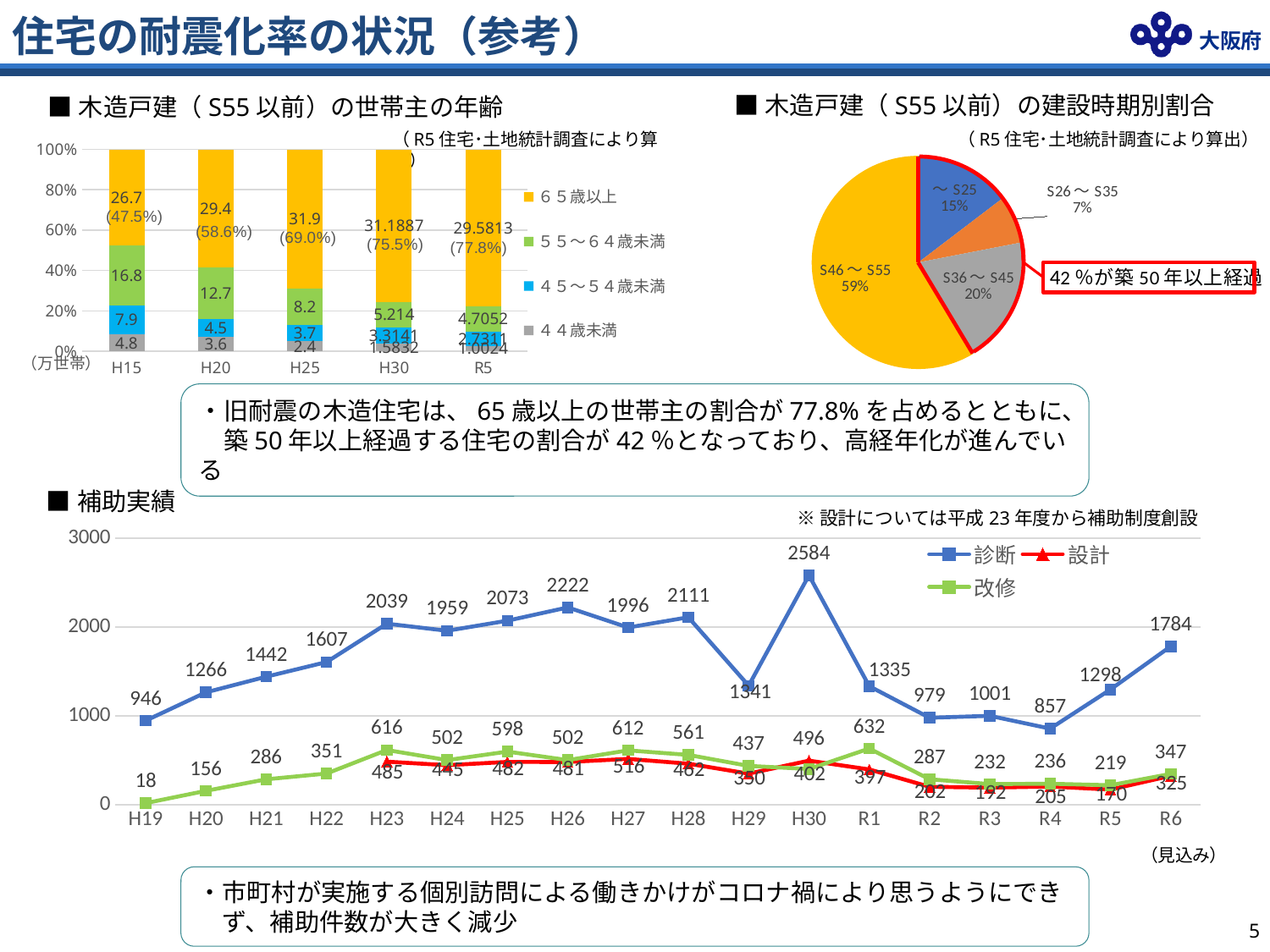
In the 補助実績 line chart, how many years are shown on the x axis? 18 In the 木造戸建（S55以前）の世帯主の年齢 chart, what is the value of 65歳以上 for H25? 31.9 In the 補助実績 line chart, what is the value of 診断 for H30? 2584 How many series does the legend of the 補助実績 line chart list? 3 In the 補助実績 line chart, which is larger for H27: 改修 or 設計? 改修 In the 木造戸建（S55以前）の建設時期別割合 pie chart, which construction period has the smallest share? S26～S35 In the 補助実績 line chart, what is the value of 改修 for R1? 632 What kind of chart is the 木造戸建（S55以前）の世帯主の年齢 chart? Stacked bar chart In the 補助実績 line chart, which year has the highest 診断 value? H30 In the 木造戸建（S55以前）の世帯主の年齢 chart, what percentage is shown for 65歳以上 in R5? 77.8% In the 木造戸建（S55以前）の建設時期別割合 pie chart, what share is S46～S55? 59% In the 補助実績 line chart, what is the difference between the 診断 values for R6 and R5? 486